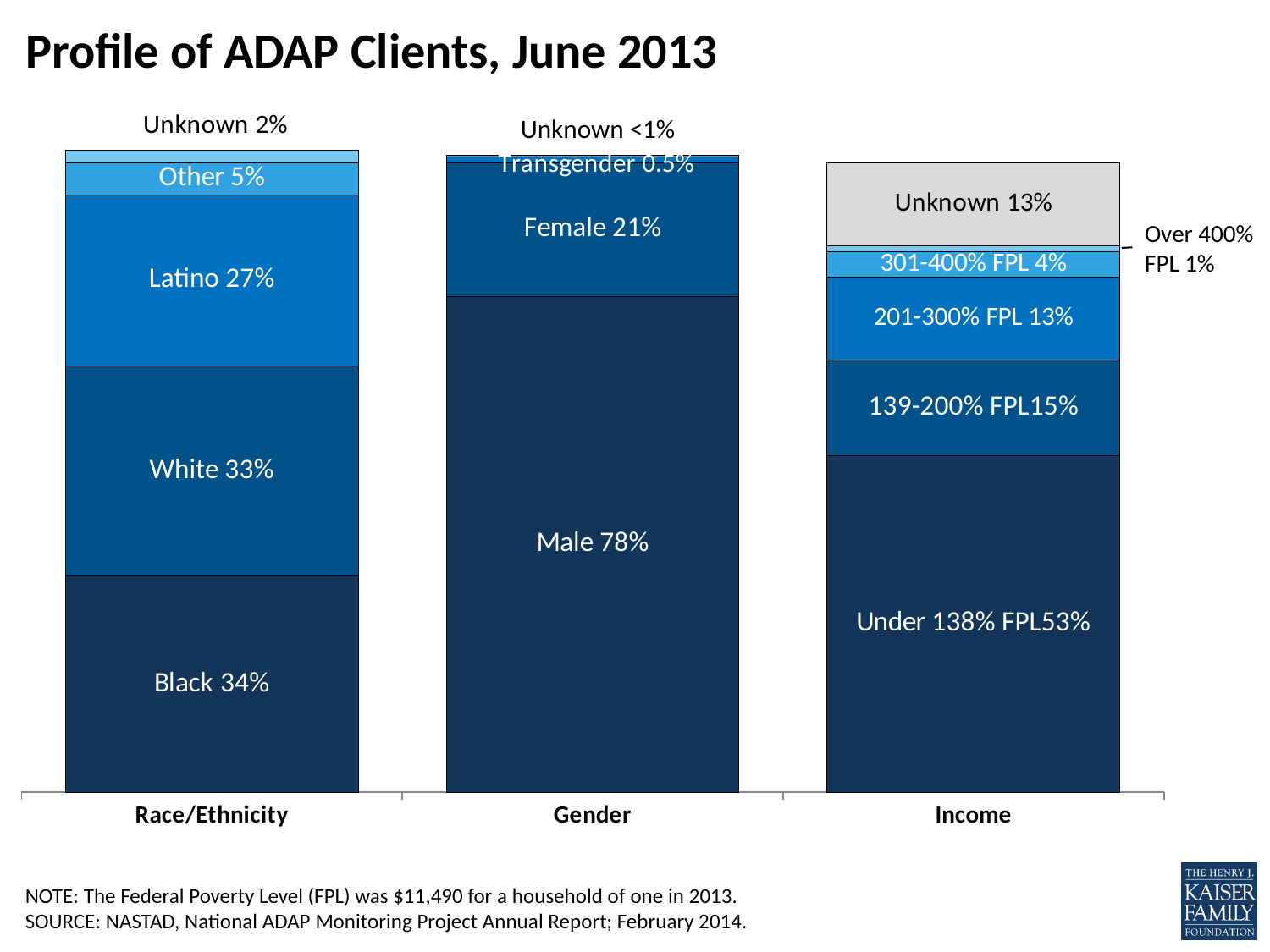
Which segment is the largest in the Income bar? Under 138% FPL What percentage of ADAP clients are Male? 78% Which is larger, the share of White clients or the share of Latino clients? White What is the difference in percentage points between Male and Female clients? 57 percentage points How many stacked bars are shown on the x axis? 3 What percentage of ADAP clients have income of 201-300% FPL? 13% What percentage of ADAP clients have income under 138% FPL? 53% What share of ADAP clients are Latino? 27% What type of chart is shown on the slide? Stacked bar chart What percentage of ADAP clients have unknown income? 13% What percentage of ADAP clients are Black according to the Race/Ethnicity bar? 34%